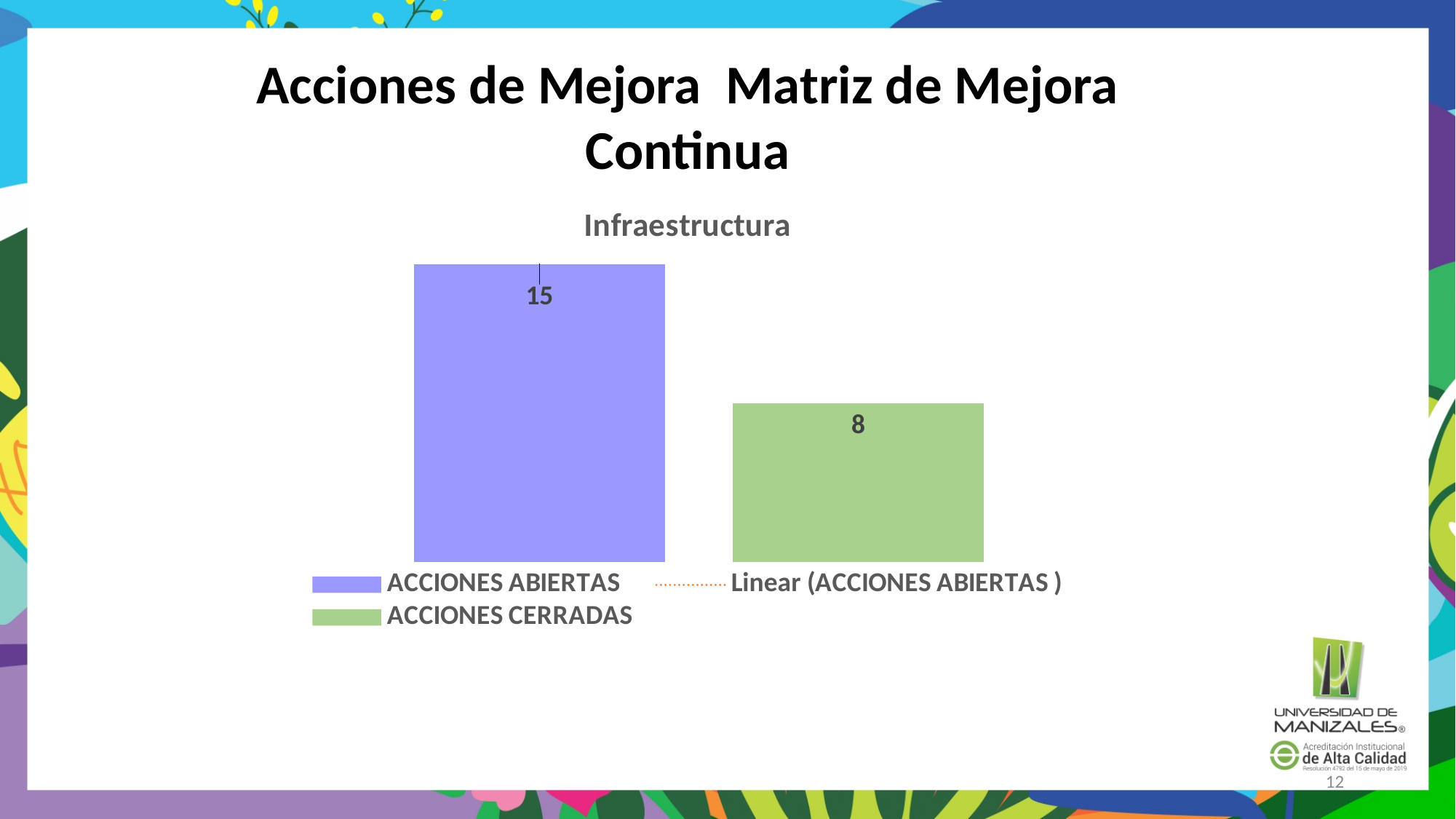
Which is larger, ACCIONES ABIERTAS or ACCIONES CERRADAS? ACCIONES ABIERTAS How many bars are plotted in the chart? 2 What is the title of the chart? Infraestructura What kind of chart is shown? bar chart Which series has the highest value? ACCIONES ABIERTAS How many entries does the legend list? 3 What is the value for ACCIONES ABIERTAS? 15 Which series has the lowest value? ACCIONES CERRADAS What colour is the bar for ACCIONES CERRADAS? green What is the value for ACCIONES CERRADAS? 8 What is the difference between ACCIONES ABIERTAS and ACCIONES CERRADAS? 7